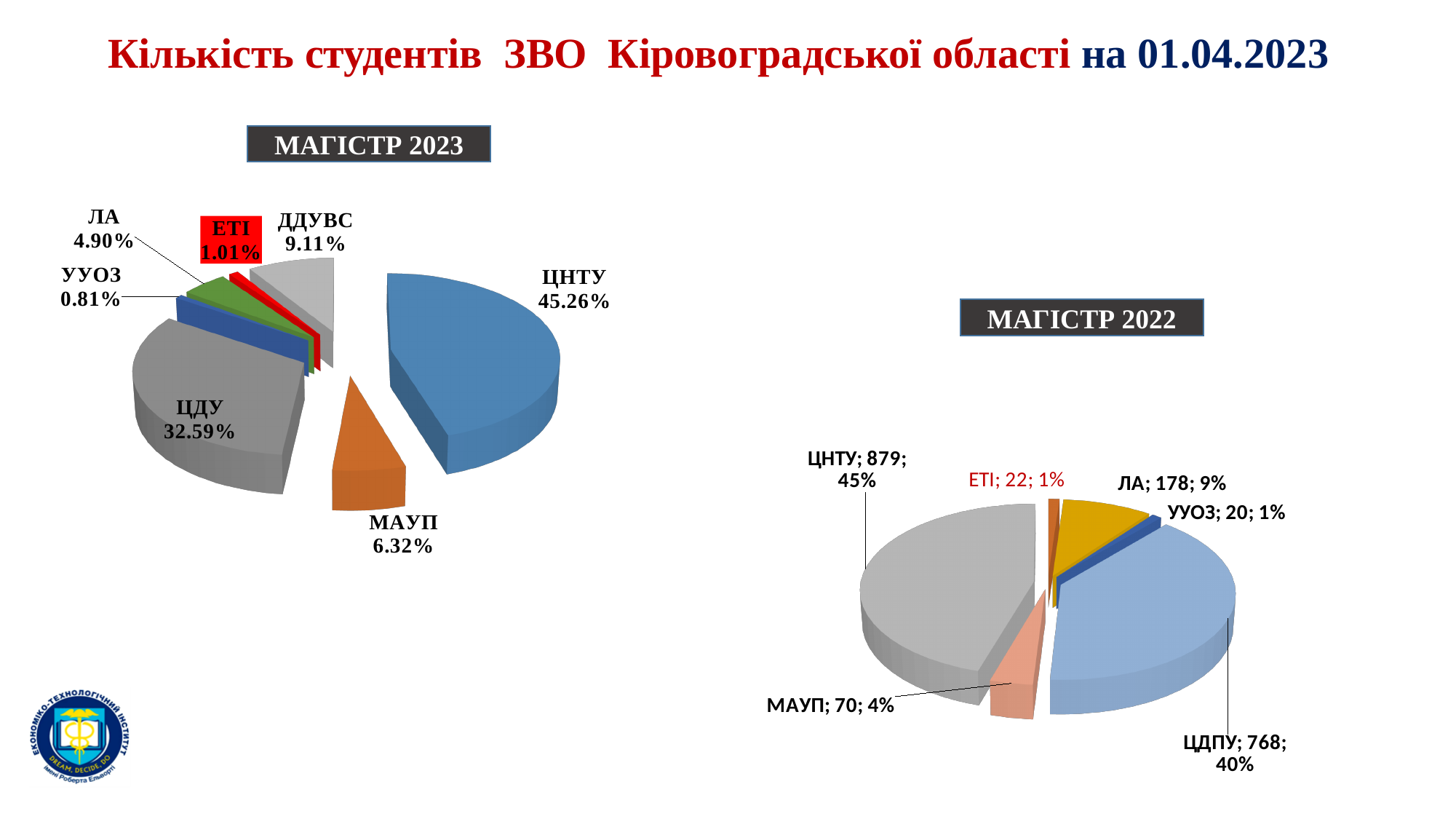
In the МАГІСТР 2023 chart, what share does ЦДУ have? 32.59% In the МАГІСТР 2023 chart, what is the difference between the shares of ДДУВС and МАУП? 2.79% In the МАГІСТР 2023 chart, what share does ЦНТУ have? 45.26% In the МАГІСТР 2022 chart, what is the value for ЕТІ? 22 In the МАГІСТР 2022 chart, what is the difference in student numbers between ЦНТУ and ЦДПУ? 111 In the МАГІСТР 2023 chart, which institution has the largest share? ЦНТУ What type of chart is the МАГІСТР 2022 chart? Pie chart In the МАГІСТР 2022 chart, which institution has the most students? ЦНТУ In the МАГІСТР 2023 chart, how many slices does the pie have? 7 In the МАГІСТР 2022 chart, how many students does ЦДПУ have? 768 In the МАГІСТР 2022 chart, which has more students, ЛА or МАУП? ЛА In the МАГІСТР 2023 chart, which institution has the smallest share? УУОЗ